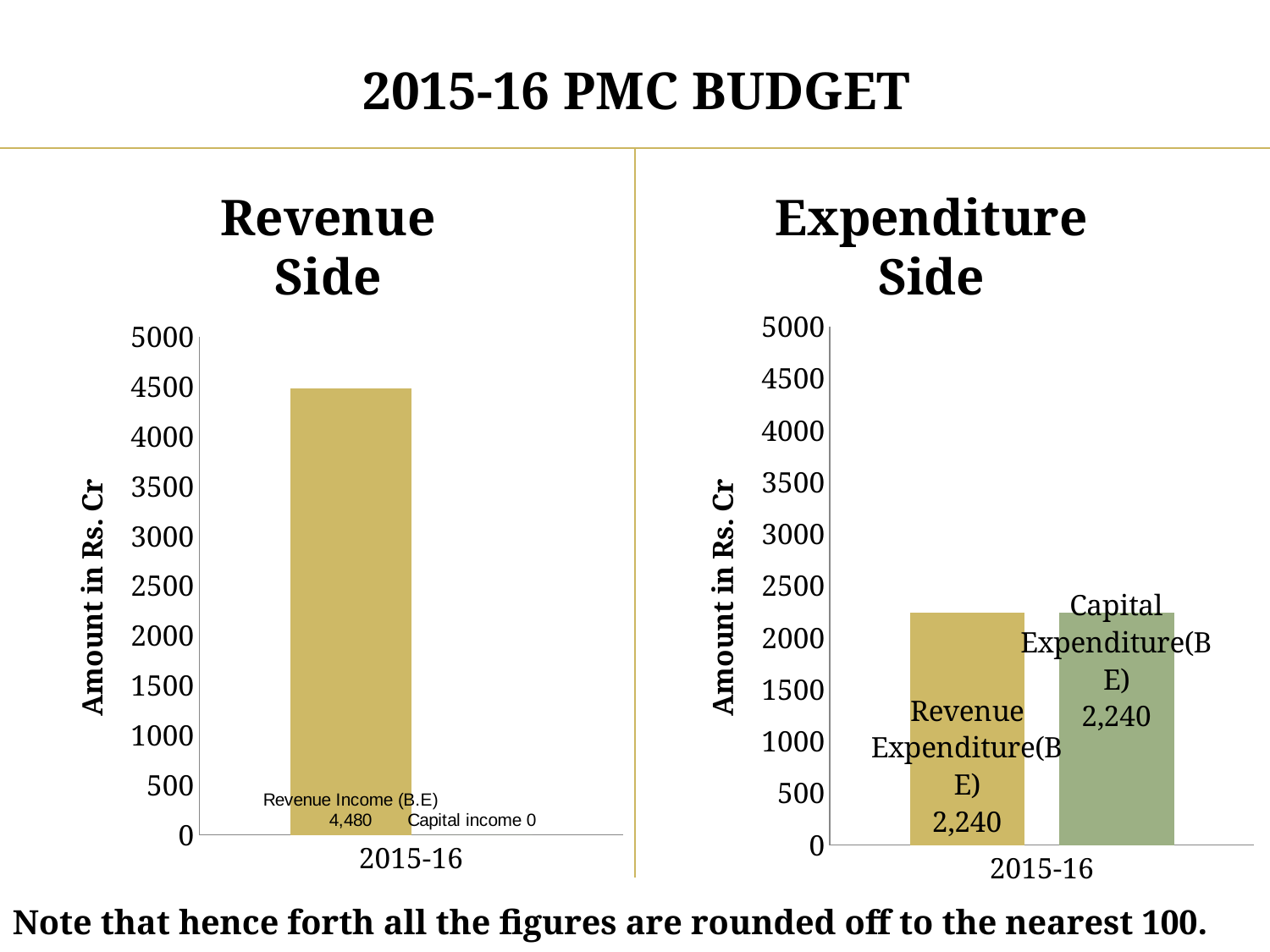
In the Revenue Side chart, is the value for Revenue Income (B.E) greater or less than 4000? greater What is the x-axis category label shown in the Expenditure Side chart? 2015-16 In the Expenditure Side chart, what is the value for Revenue Expenditure(BE)? 2,240 In the Expenditure Side chart, what is the value for Capital Expenditure(BE)? 2,240 In the Revenue Side chart, what is the value for Revenue Income (B.E)? 4,480 What kind of chart is the Expenditure Side chart? bar chart In the Revenue Side chart, what is the value for Capital income? 0 In the Expenditure Side chart, is the value for Capital Expenditure(BE) greater or less than 2500? less In the Revenue Side chart, which category has the highest value? Revenue Income (B.E) In the Revenue Side chart, what is the difference between Revenue Income (B.E) and Capital income? 4,480 In the Expenditure Side chart, what is the difference between Revenue Expenditure(BE) and Capital Expenditure(BE)? 0 What is the y-axis label of the Revenue Side chart? Amount in Rs. Cr